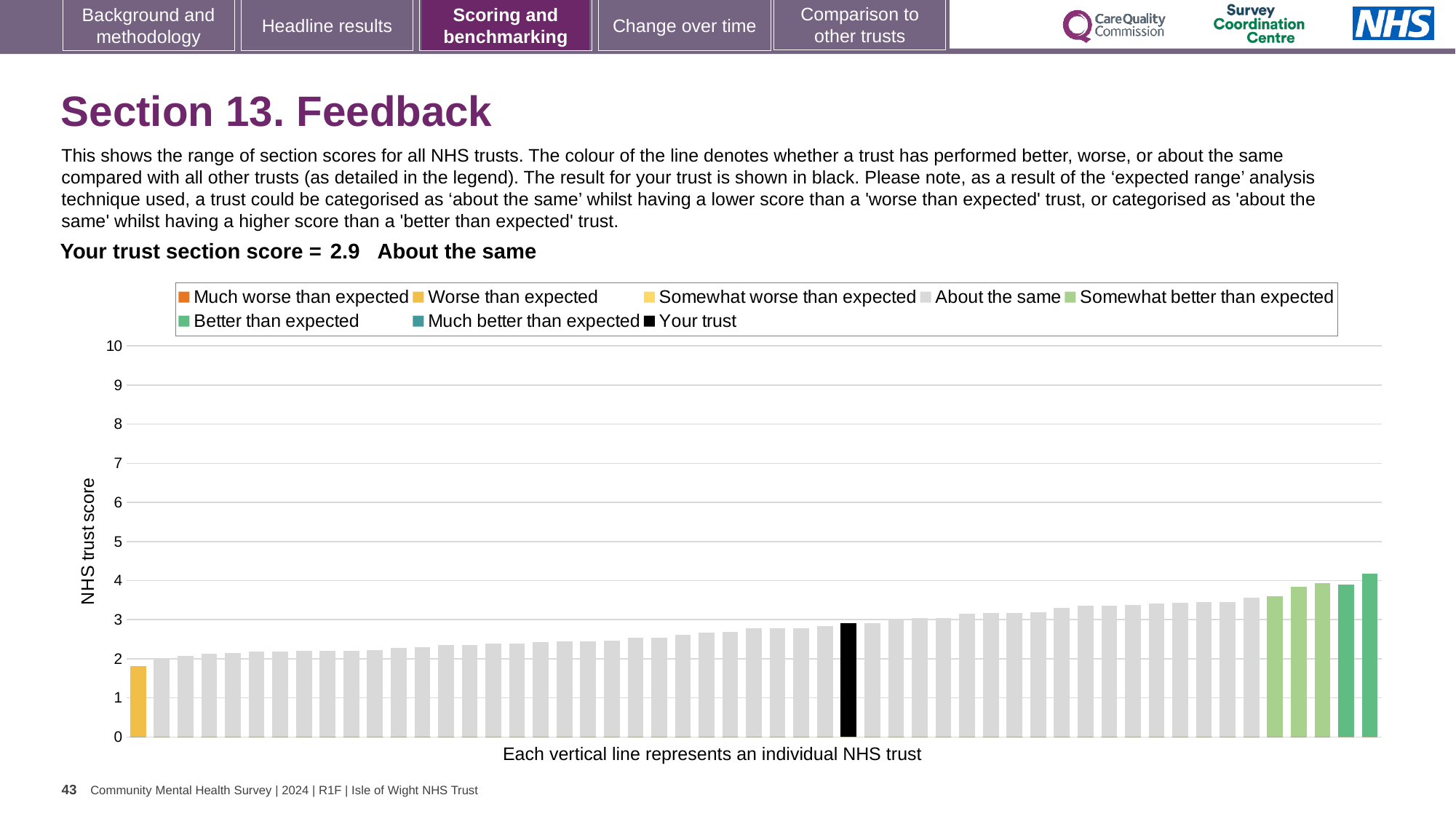
What kind of chart is shown on the slide? bar chart How many bars are coloured green (somewhat better or better than expected)? 5 Which legend category does the highest bar on the chart belong to? Better than expected What is the section score for your trust shown on the slide? 2.9 Which performance category is your trust placed in for Section 13? About the same Is the value for your trust (the black bar) greater or less than 5? less Do the bar values rise or fall from left to right along the x axis? rise Is the value for the highest bar greater or less than 3? greater How many entries does the chart legend list? 8 How many bars are coloured yellow (Worse than expected)? 1 Is the value for the lowest bar (the yellow bar) greater or less than 3? less What is the label on the vertical axis of the chart? NHS trust score